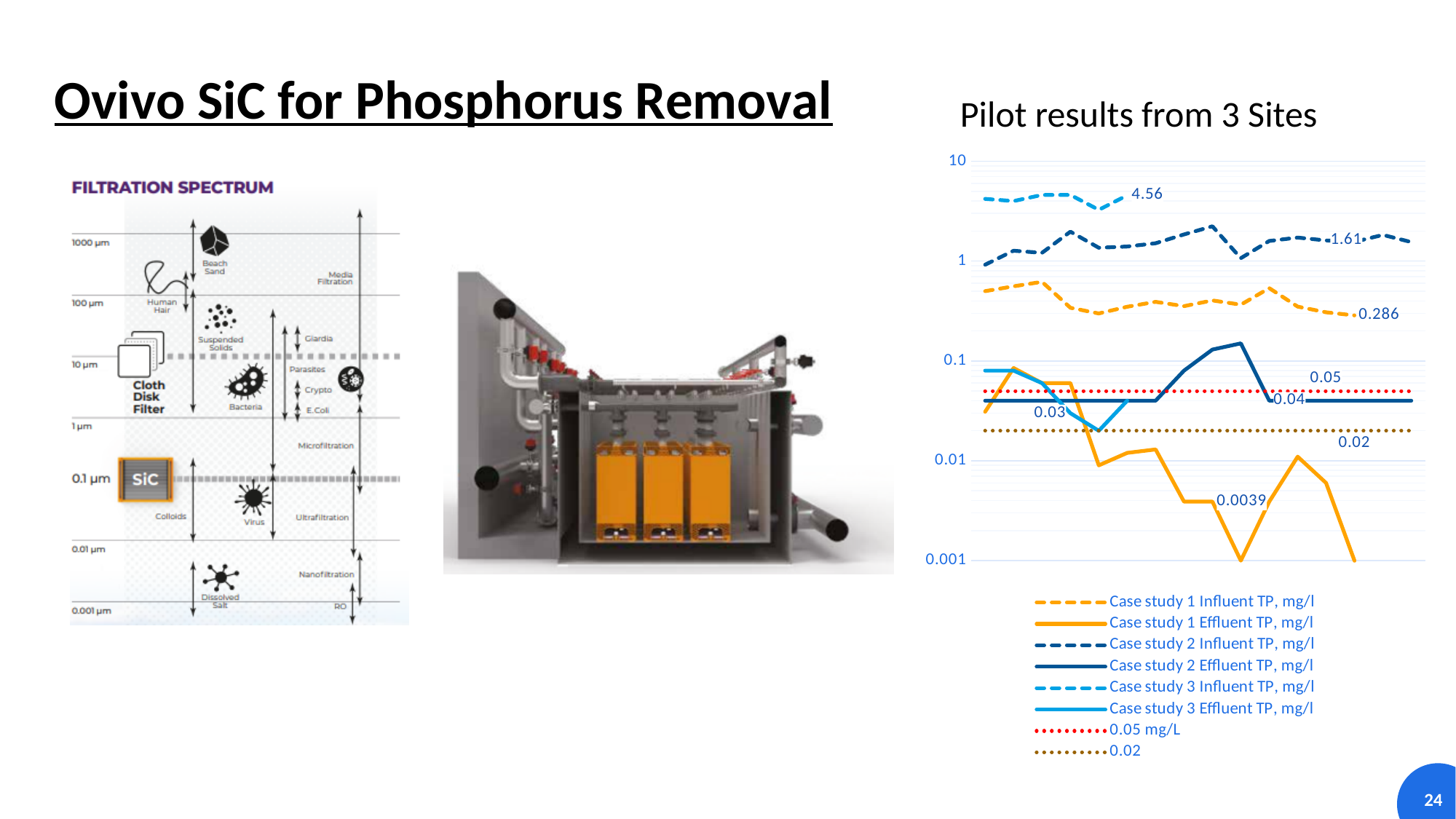
In the "Pilot results from 3 Sites" chart, what value is labelled on the Case study 1 Influent TP line? 0.286 In the "Pilot results from 3 Sites" chart, which of the three influent series has the highest labelled value? Case study 3 Influent TP, mg/l In the "Pilot results from 3 Sites" chart, is the final value of the Case study 1 Effluent TP line greater or less than 0.01? less In the "Pilot results from 3 Sites" chart, what is the difference between the labelled Case study 3 Influent TP value (4.56) and the labelled Case study 2 Influent TP value (1.61)? 2.95 How many series does the legend of the "Pilot results from 3 Sites" chart list? 8 In the "Pilot results from 3 Sites" chart, what value is labelled on the Case study 1 Effluent TP line? 0.0039 In the "Pilot results from 3 Sites" chart, what value is labelled on the Case study 2 Effluent TP line? 0.04 In the "Pilot results from 3 Sites" chart, what value is labelled on the Case study 3 Influent TP line? 4.56 What kind of chart is shown under the title "Pilot results from 3 Sites"? line chart In the "Pilot results from 3 Sites" chart, which is higher: the labelled Case study 3 Influent TP value or the labelled Case study 2 Influent TP value? Case study 3 Influent TP In the "Pilot results from 3 Sites" chart, what value does the red dotted reference line represent according to the legend? 0.05 mg/L In the "Pilot results from 3 Sites" chart, what value is labelled on the Case study 2 Influent TP line? 1.61